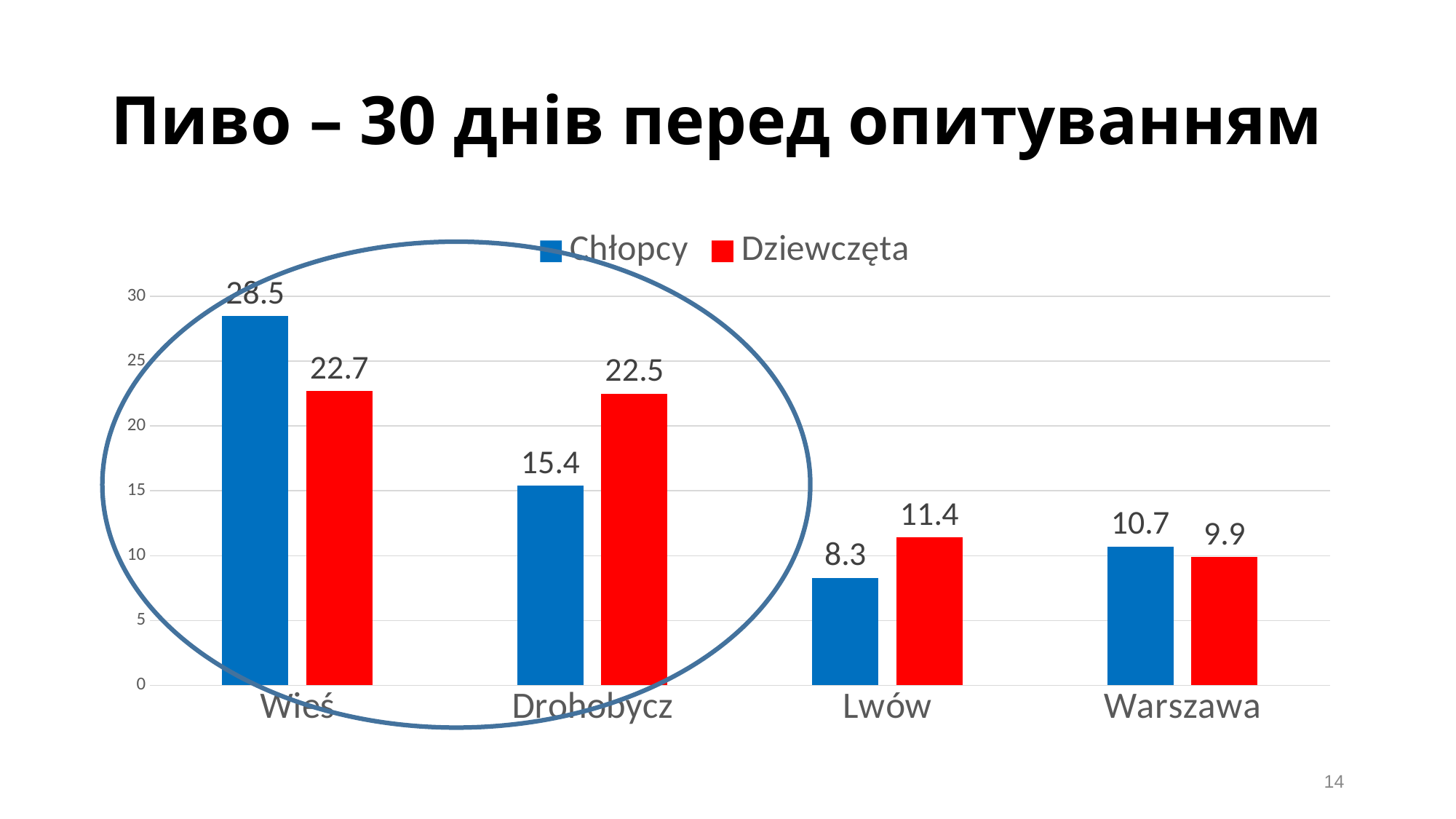
What is the value for Dziewczęta in Warszawa? 9.9 What is the difference between the Dziewczęta values for Wieś and Lwów? 11.3 Which category has the highest value for Chłopcy? Wieś What is the value for Chłopcy in Drohobycz? 15.4 What is the difference between the Chłopcy and Dziewczęta values in Drohobycz? 7.1 How many series does the legend list? 2 Is the value for Chłopcy in Wieś greater or less than 25? greater What is the value for Dziewczęta in Lwów? 11.4 Which category has the lowest value for Dziewczęta? Warszawa What kind of chart is shown on the slide? bar chart Which is larger in Lwów, the value for Chłopcy or for Dziewczęta? Dziewczęta How many categories are shown on the x axis? 4